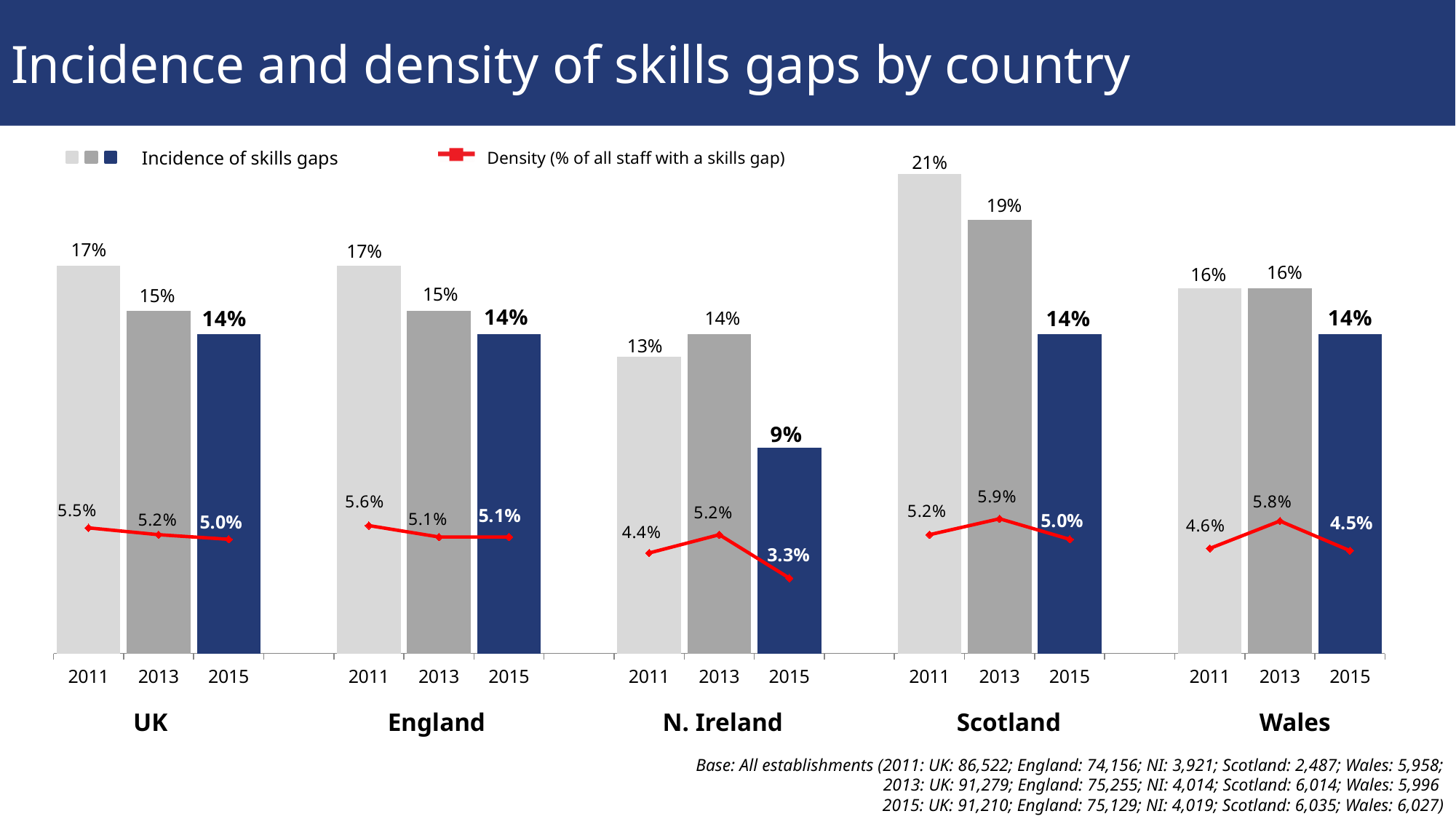
What is the density of skills gaps for N. Ireland in 2015? 3.3% Which is larger, the density of skills gaps for Scotland in 2013 or for Wales in 2013? Scotland in 2013 What is the incidence of skills gaps for Wales in 2013? 16% Which country has the lowest incidence of skills gaps in 2015? N. Ireland What is the incidence of skills gaps for Scotland in 2011? 21% Does the incidence of skills gaps for the UK rise or fall from 2011 to 2015? fall What is the difference between the incidence of skills gaps in Scotland in 2011 and in 2015? 7% What colour is the line showing density of skills gaps? red Which country has the highest incidence of skills gaps in 2011? Scotland How many countries are shown on the chart? 5 What kind of chart is used to show the incidence of skills gaps? bar chart How many series does the legend list? 2